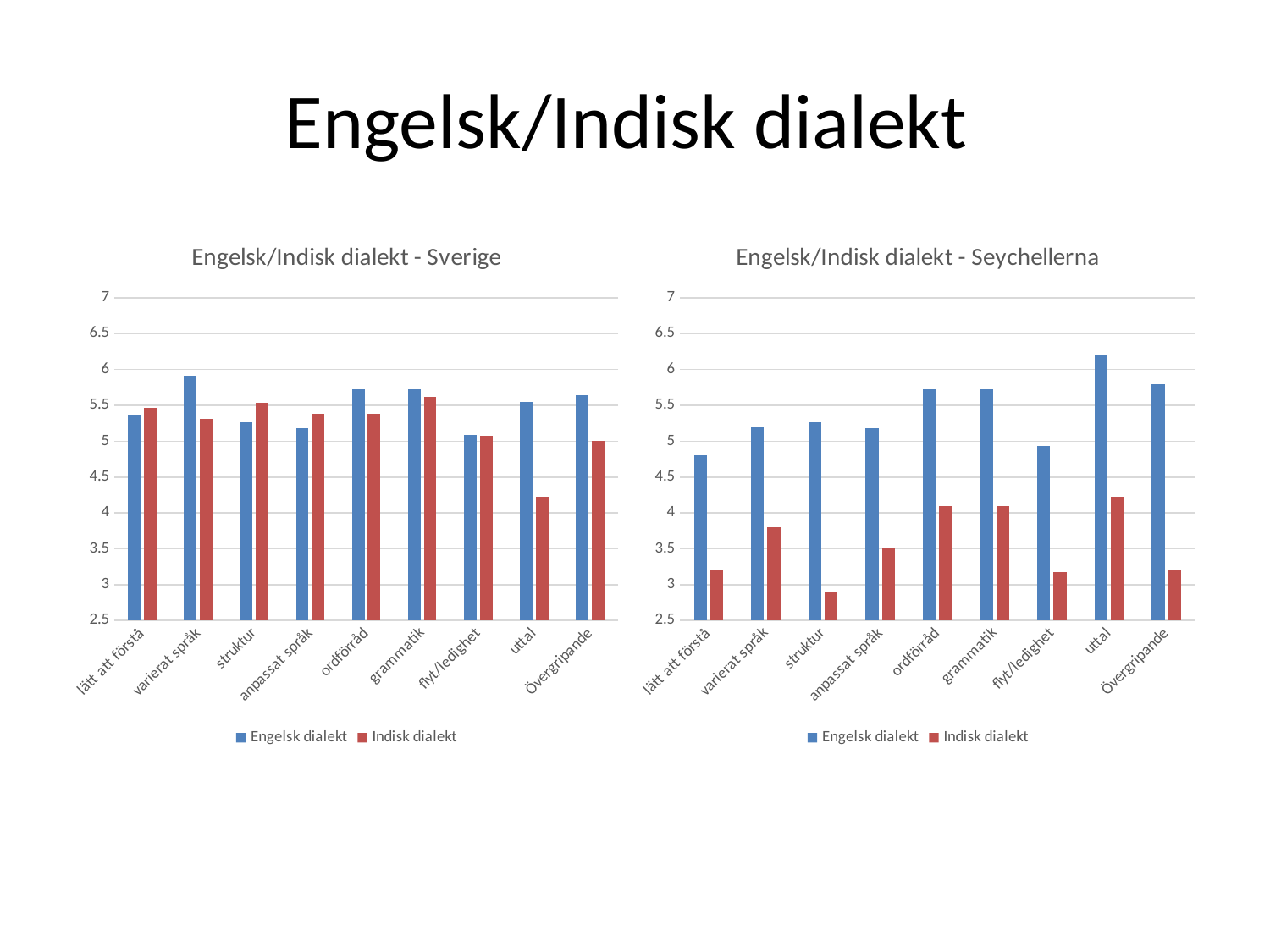
In the 'Engelsk/Indisk dialekt - Seychellerna' chart, is the value for Engelsk dialekt at uttal greater or less than 6? greater In the 'Engelsk/Indisk dialekt - Seychellerna' chart, which category has the highest value for Engelsk dialekt? uttal In the 'Engelsk/Indisk dialekt - Seychellerna' chart, which series has the larger value at lätt att förstå, Engelsk dialekt or Indisk dialekt? Engelsk dialekt Which colour represents Indisk dialekt in the 'Engelsk/Indisk dialekt - Sverige' chart? red What kind of chart is the 'Engelsk/Indisk dialekt - Sverige' chart? bar chart How many series does the legend of the 'Engelsk/Indisk dialekt - Sverige' chart list? 2 How many categories are shown on the x axis of the 'Engelsk/Indisk dialekt - Seychellerna' chart? 9 In the 'Engelsk/Indisk dialekt - Seychellerna' chart, which category has the lowest value for Indisk dialekt? struktur In the 'Engelsk/Indisk dialekt - Sverige' chart, which category has the highest value for Engelsk dialekt? varierat språk In the 'Engelsk/Indisk dialekt - Sverige' chart, which category has the lowest value for Indisk dialekt? uttal In the 'Engelsk/Indisk dialekt - Seychellerna' chart, is the value for Indisk dialekt at struktur greater or less than 3? less In the 'Engelsk/Indisk dialekt - Sverige' chart, is the value for Indisk dialekt at uttal greater or less than 4.5? less